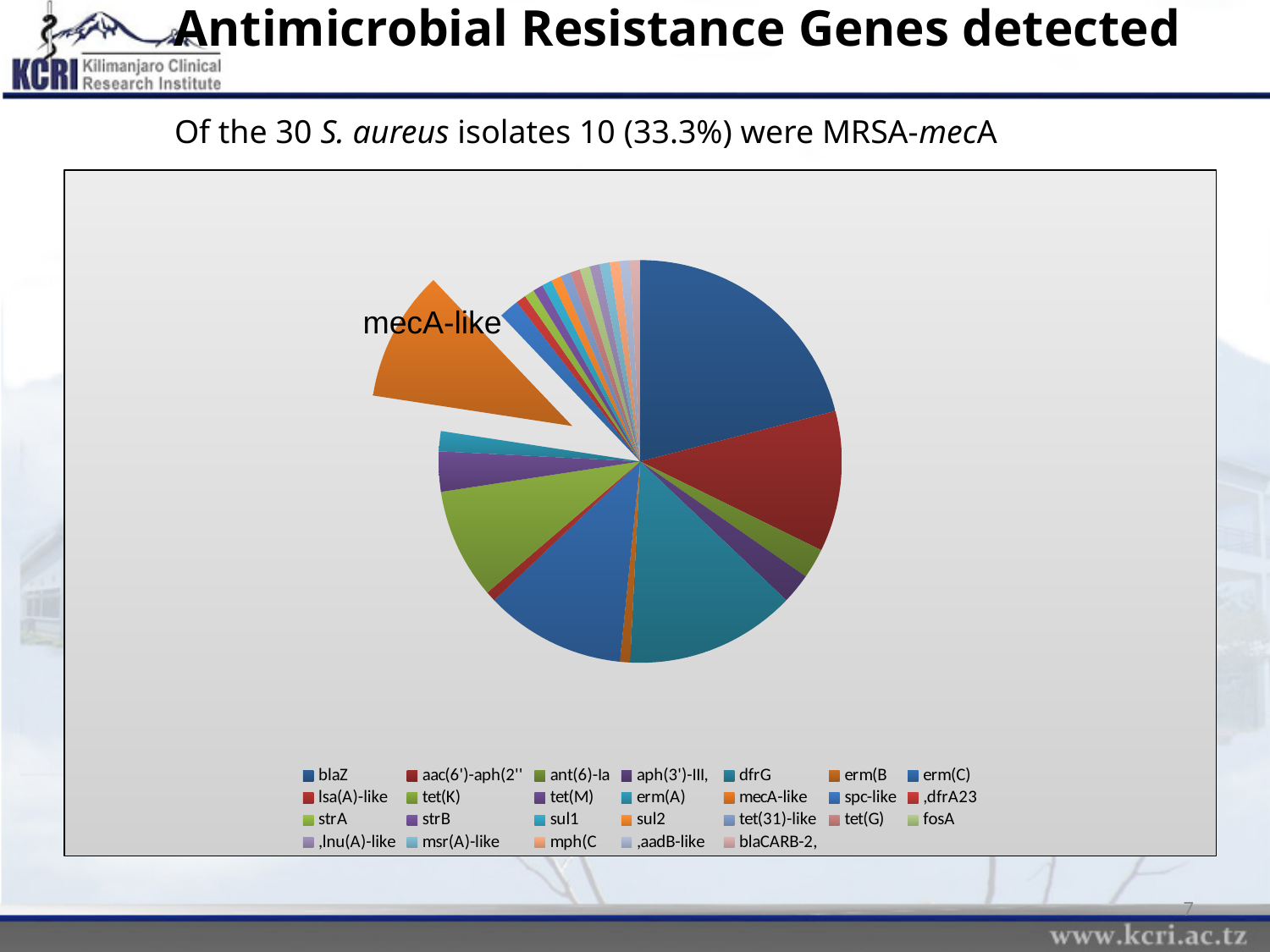
Which slice is larger, blaZ or mecA-like? blaZ Which gene name is written as a text label directly on the pie chart? mecA-like Which slice of the pie chart is pulled out (exploded) from the rest of the pie? mecA-like What kind of chart is shown on the slide? pie chart Which slice is larger, aac(6')-aph(2'') or ant(6)-Ia? aac(6')-aph(2'') Which slice is larger, blaZ or dfrG? blaZ Which gene has the largest slice in the pie chart? blaZ How many genes (categories) does the legend of the pie chart list? 26 What is the title of the slide containing the pie chart? Antimicrobial Resistance Genes detected